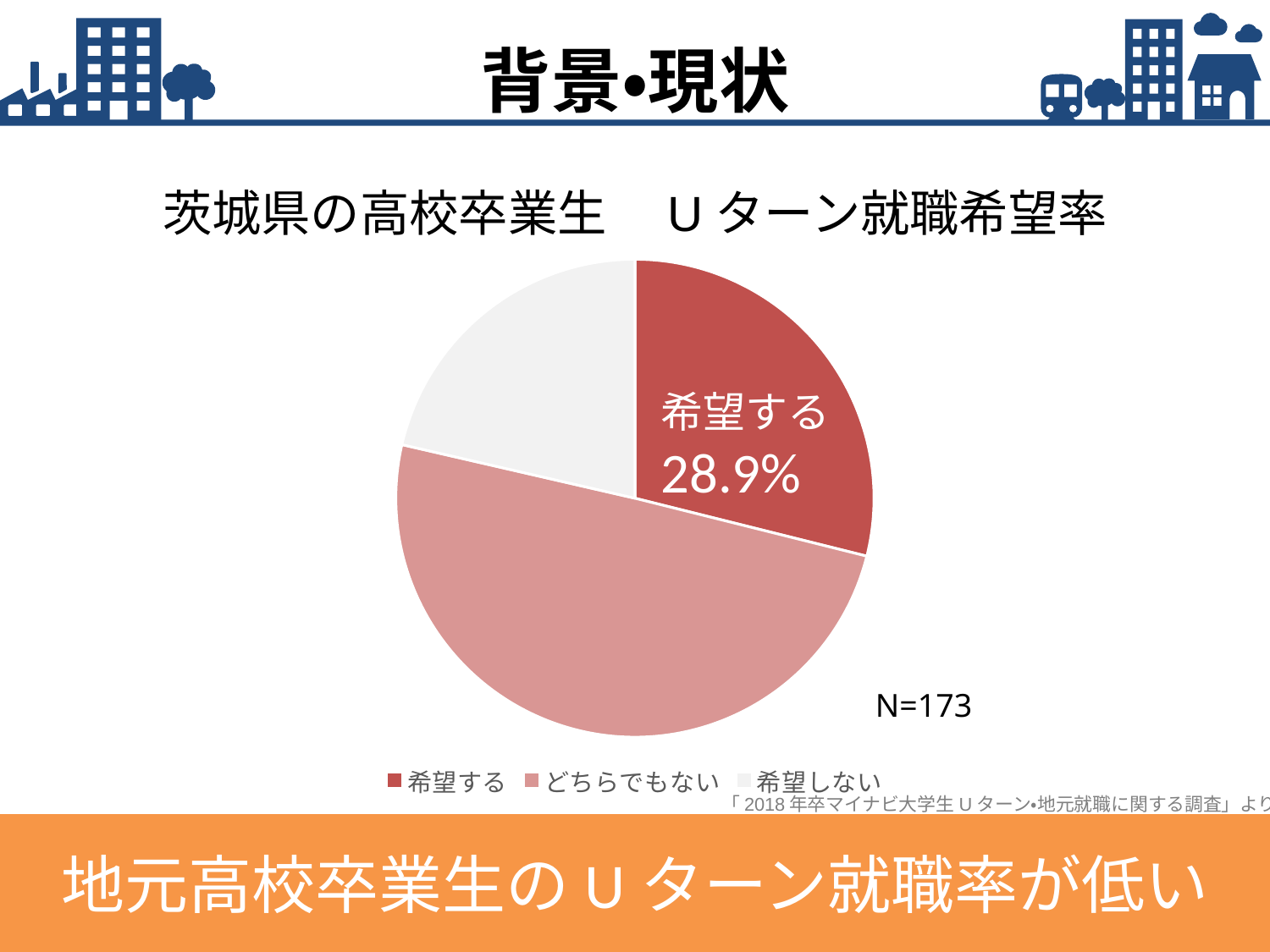
What sample size (N) is shown next to the chart? N=173 How many entries does the legend list? 3 How many categories does the pie chart show? 3 Which category has the largest slice in the pie chart? どちらでもない What share of the pie does the 希望する slice represent? 28.9% What percentage of the pie chart is labelled for 希望する? 28.9% Which slice is larger, 希望する or どちらでもない? どちらでもない What is the title of the chart? 茨城県の高校卒業生 Uターン就職希望率 What kind of chart is shown on the slide? Pie chart